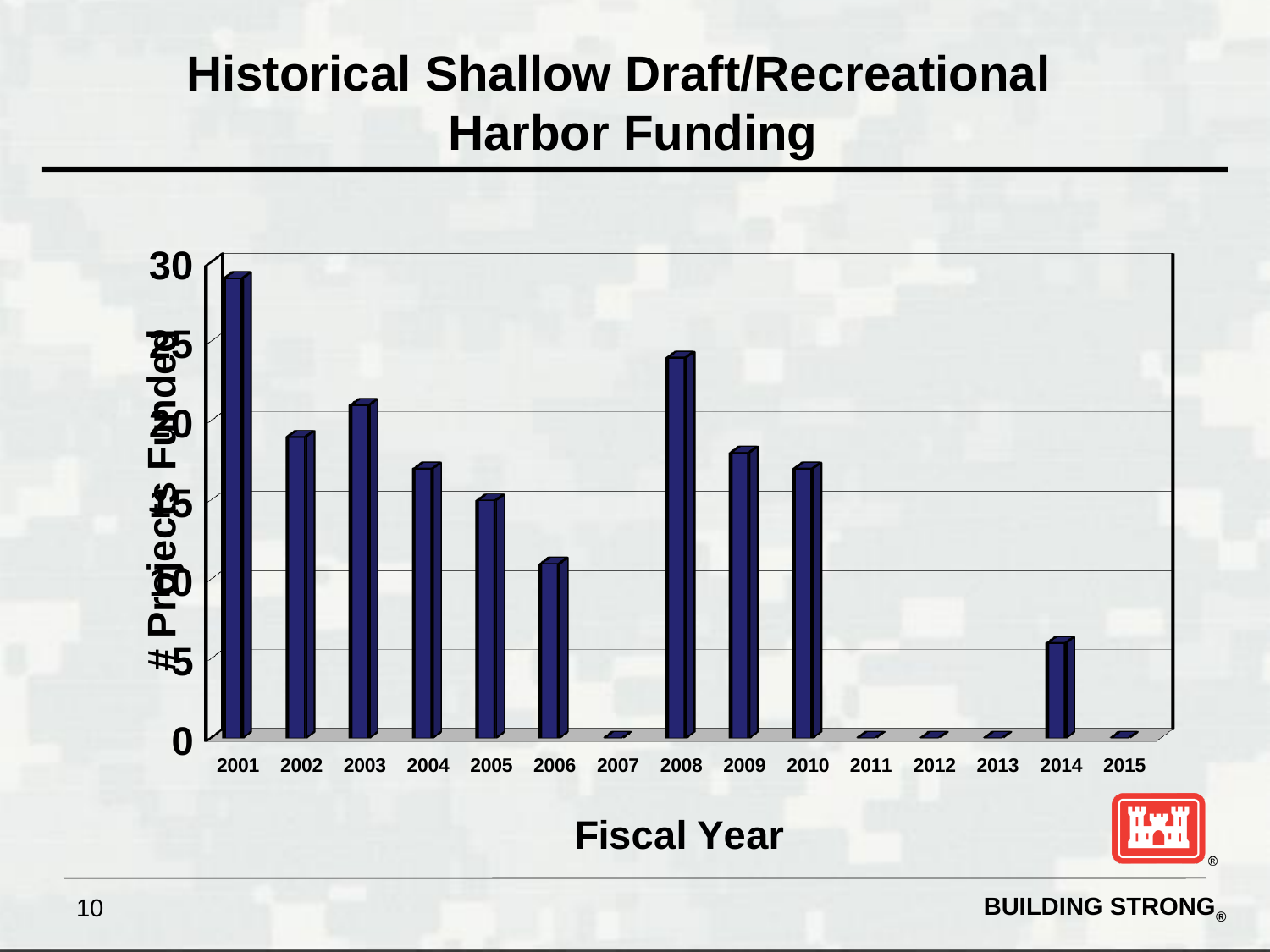
Do the values rise or fall from 2001 to 2006? fall overall, with a rise in 2003 What is the title of the x axis? Fiscal Year What kind of chart is shown on the slide? bar chart Which is larger, the value for 2003 or the value for 2002? 2003 Which fiscal year has the highest number of projects funded? 2001 Is the value for 2004 greater or less than 15? greater Is the value for 2014 greater or less than 10? less How many fiscal years are shown on the x axis? 15 Is the value for 2001 greater or less than 25? greater Which is larger, the value for 2001 or the value for 2008? 2001